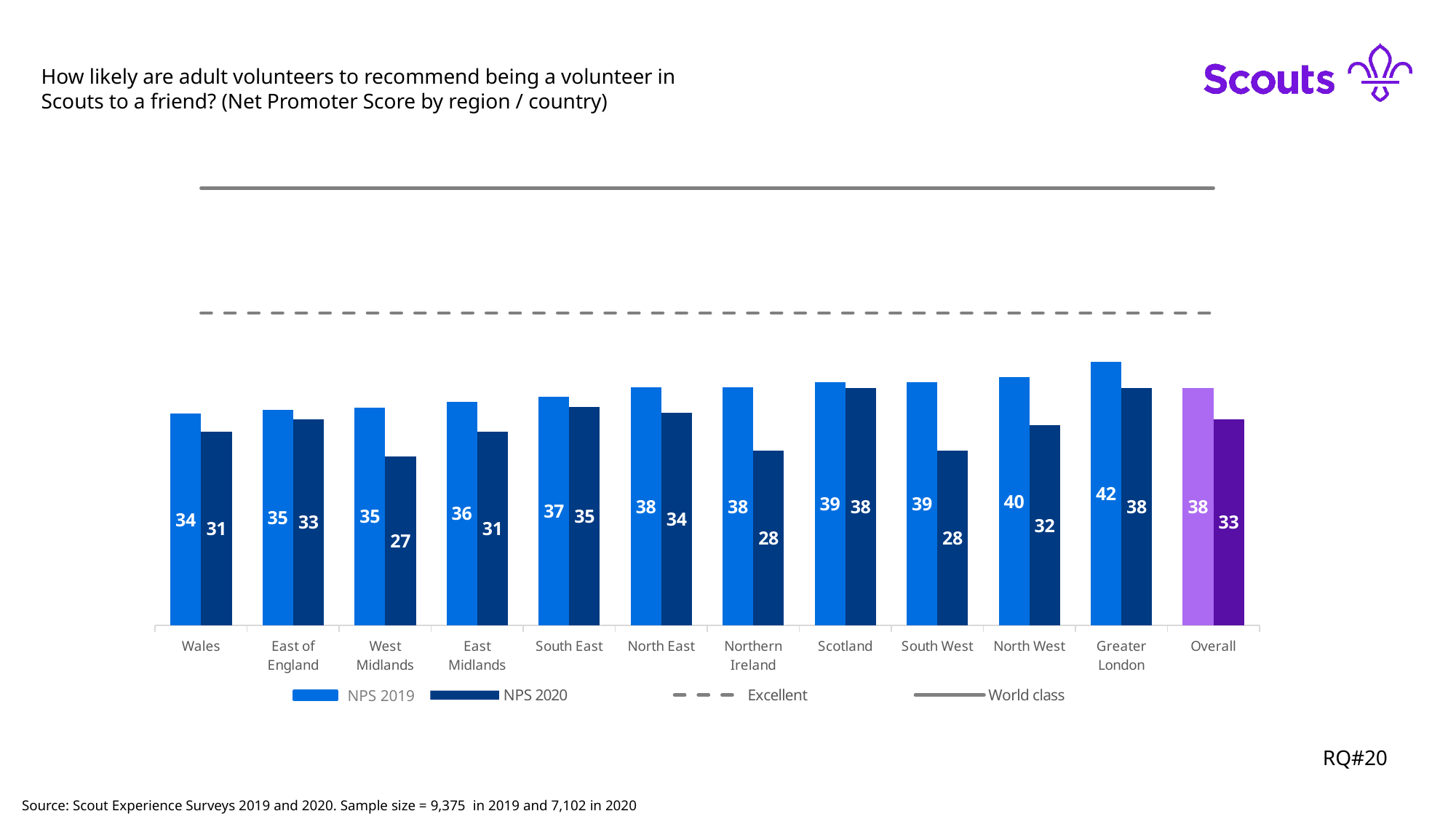
What does the dashed horizontal line represent according to the legend? Excellent What is the NPS 2019 value for Greater London? 42 What kind of chart is shown on the slide? Bar chart Which region or country has the highest NPS 2019 value? Greater London How many regions or countries (including Overall) are shown on the x axis? 12 Which is larger for Scotland: the NPS 2019 value or the NPS 2020 value? NPS 2019 What is the NPS 2020 value for West Midlands? 27 What is the difference between the NPS 2019 and NPS 2020 values for Northern Ireland? 10 Which region or country has the lowest NPS 2020 value? West Midlands Do the NPS 2019 values rise or fall from Wales to Greater London along the x axis? Rise What is the Overall NPS 2020 value? 33 How many entries does the legend list? 4